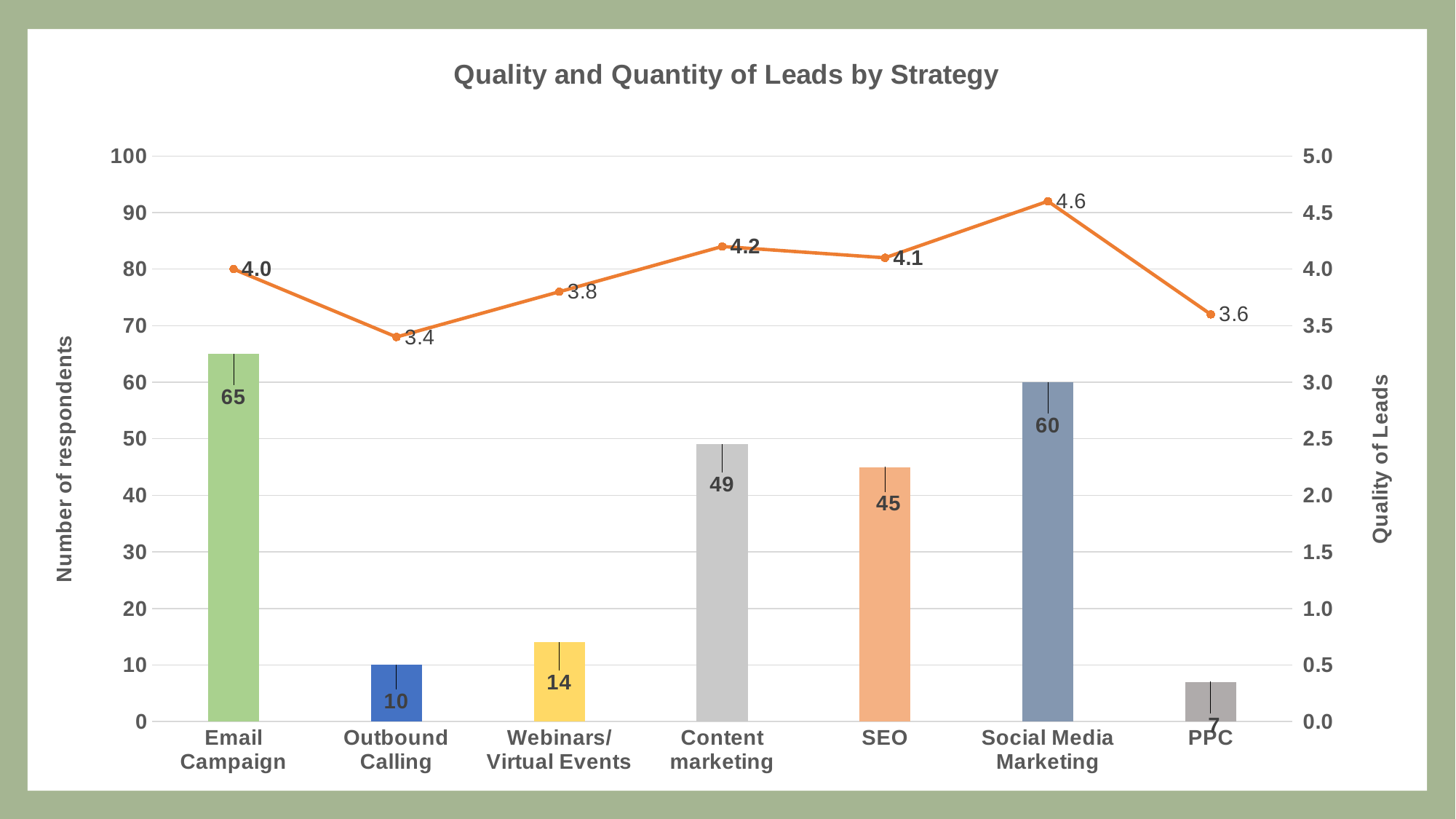
What is the title of the chart? Quality and Quantity of Leads by Strategy How many strategies are shown on the x axis? 7 What is the number of respondents for Email Campaign? 65 What is the number of respondents for PPC? 7 What is the quality of leads value for Social Media Marketing? 4.6 Which has more respondents, Content marketing or Webinars/Virtual Events? Content marketing What is the label of the right-hand vertical axis? Quality of Leads What kind of chart is this? Combined bar and line chart What is the quality of leads value for Outbound Calling? 3.4 What is the difference in number of respondents between Social Media Marketing and SEO? 15 Which strategy has the highest number of respondents? Email Campaign Which strategy has the lowest quality of leads value? Outbound Calling